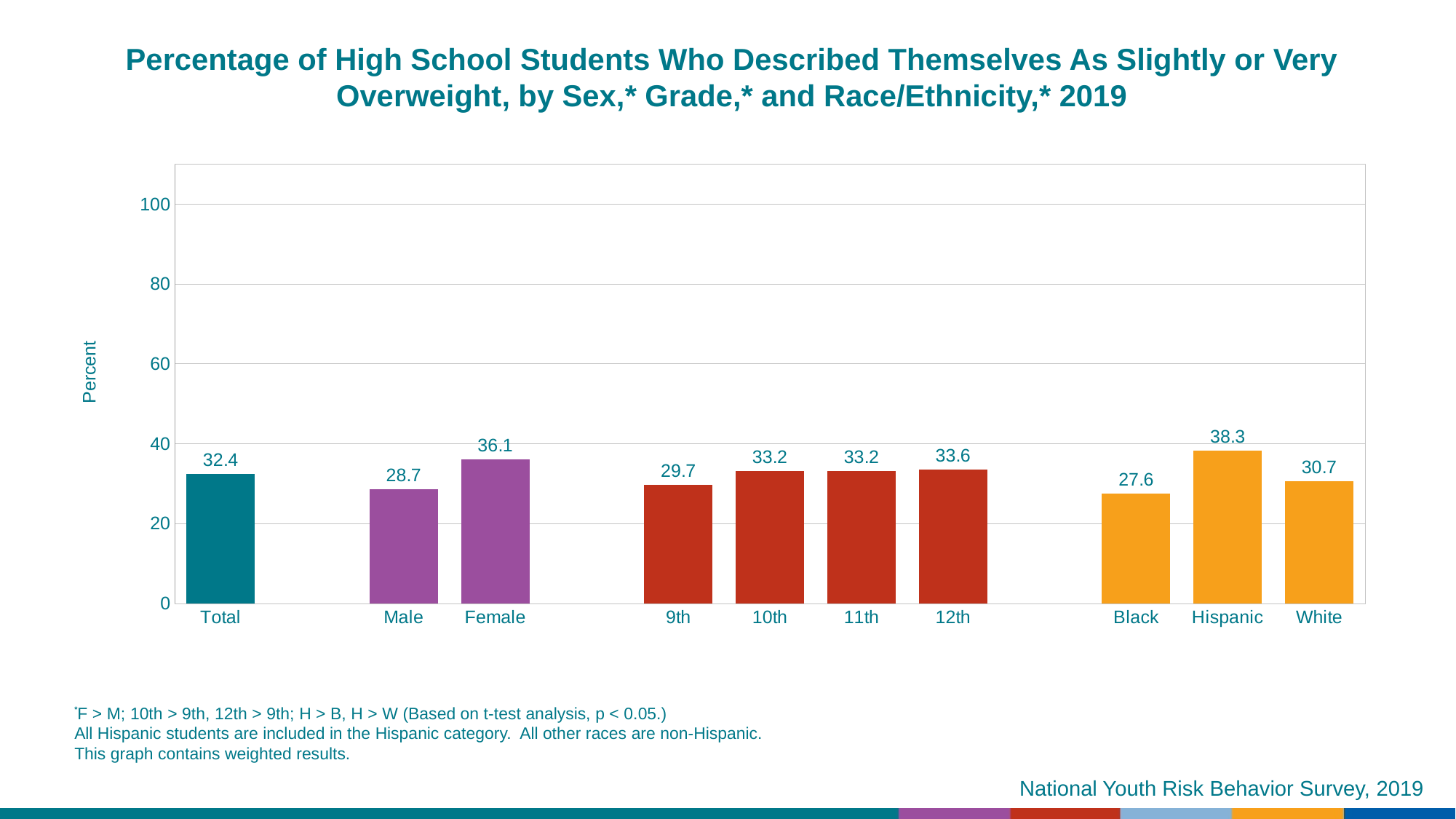
Which is larger, the value for 12th or the value for 9th? 12th Which category has the lowest value? Black What kind of chart is this? bar chart What is the value for Black? 27.6 Is the value for Hispanic greater or less than 40? less Which category has the highest value? Hispanic What is the value for Total? 32.4 What is the label on the y axis? Percent What is the value for Female? 36.1 What is the difference between the Hispanic and White values? 7.6 How many categories are shown on the x axis? 10 What is the difference between the Female and Male values? 7.4